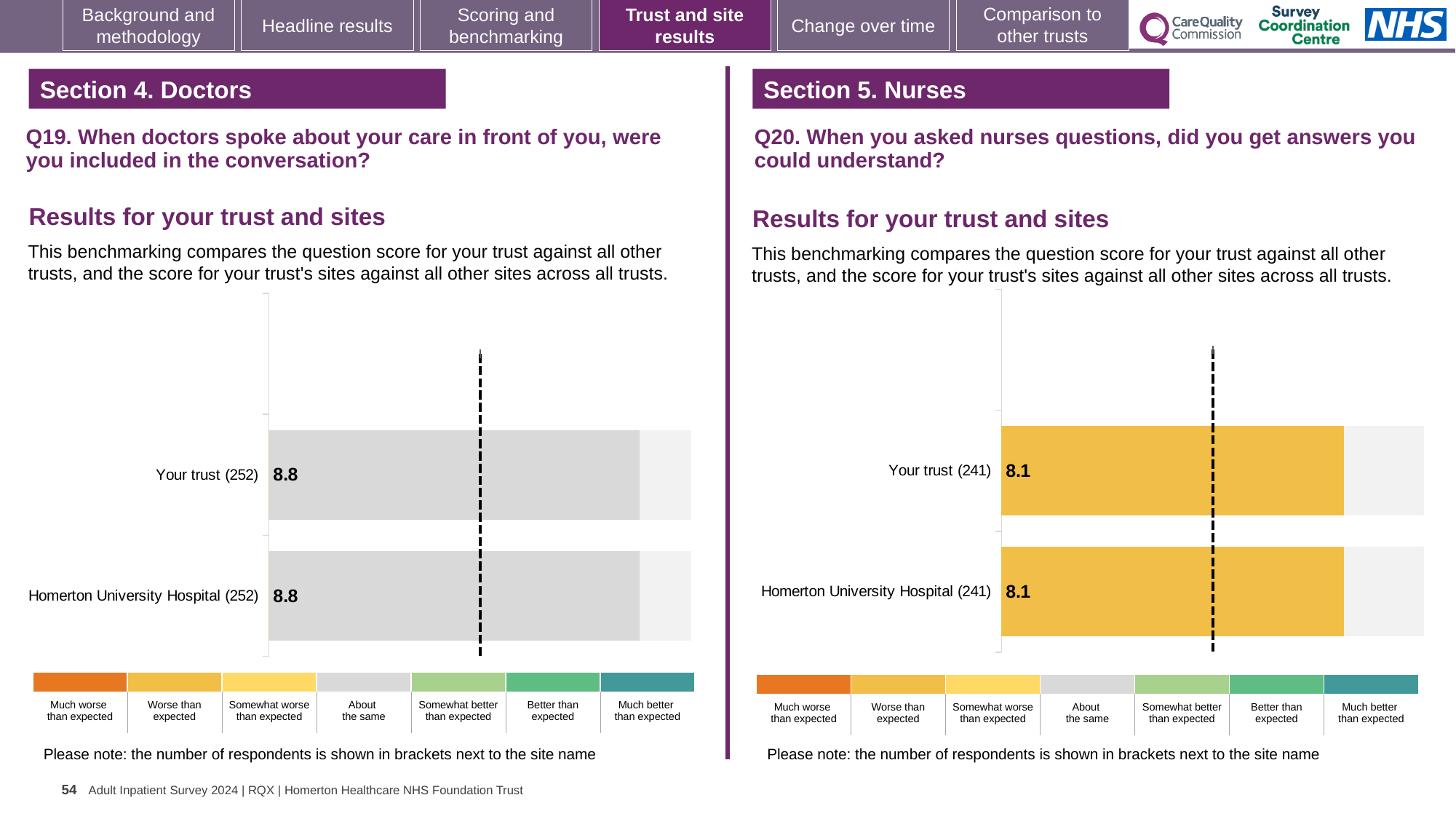
In the Q19 chart (Section 4. Doctors), how many respondents are shown in brackets for Your trust? 252 In the Q20 chart (Section 5. Nurses), what is the score for Your trust? 8.1 How many bars are plotted in the Q20 chart (Section 5. Nurses)? 2 In the Q20 chart (Section 5. Nurses), what is the score for Homerton University Hospital? 8.1 What is the difference between the Your trust score in the Q19 chart and the Your trust score in the Q20 chart? 0.7 In the Q19 chart (Section 4. Doctors), what is the score for Homerton University Hospital? 8.8 In the Q19 chart (Section 4. Doctors), what is the score for Your trust? 8.8 How many categories does the colour key below the Q19 chart (Section 4. Doctors) list? 7 How many bars are plotted in the Q19 chart (Section 4. Doctors)? 2 Which is larger: the Your trust score in the Q19 chart or the Your trust score in the Q20 chart? Q19 chart In the Q20 chart (Section 5. Nurses), how many respondents are shown in brackets for Homerton University Hospital? 241 What kind of chart is used in the Q20 chart (Section 5. Nurses)? Bar chart